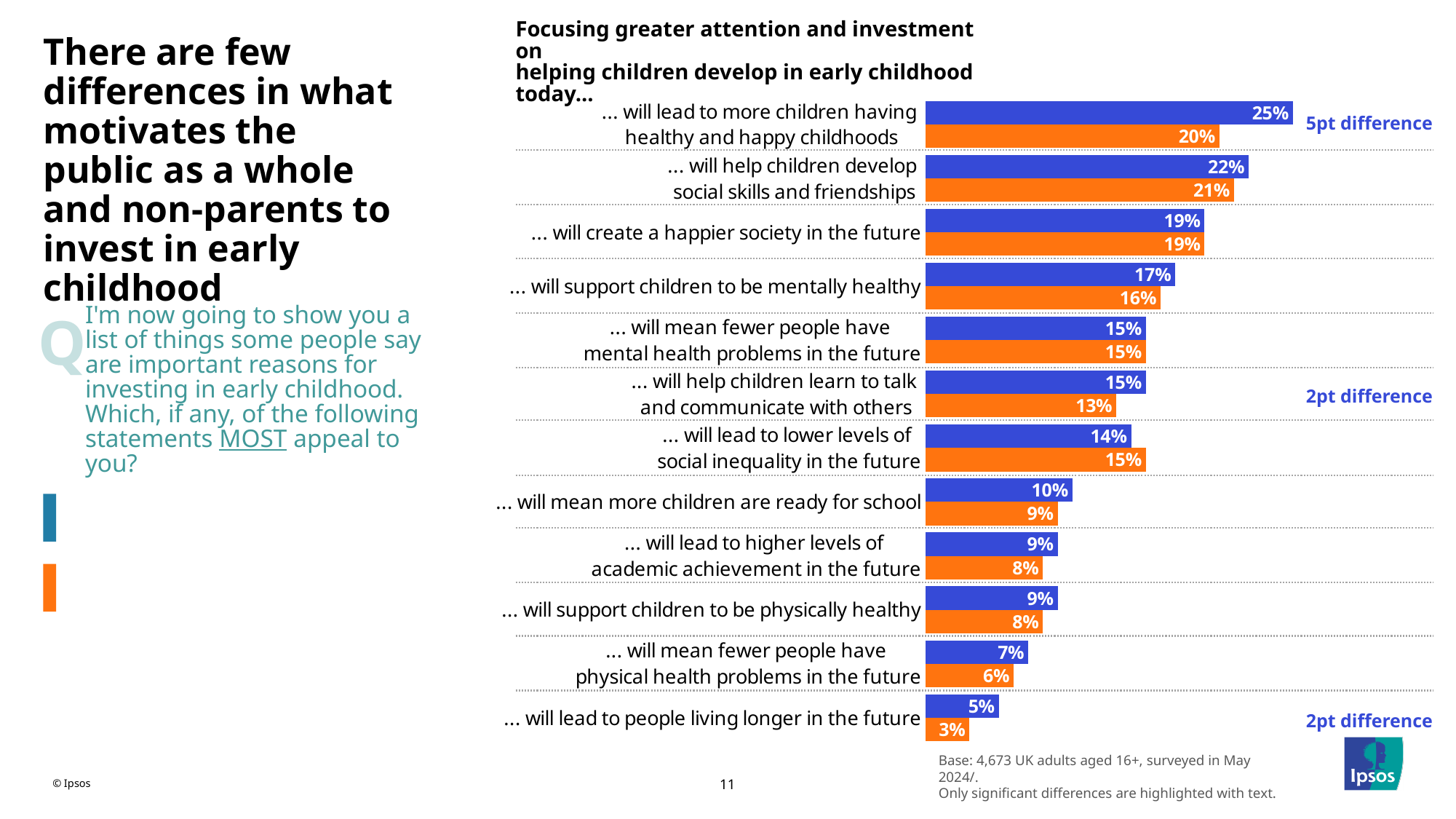
How many statements (categories) are listed in the chart? 12 For '... will lead to lower levels of social inequality in the future', which bar is larger, blue or orange? orange What annotation is shown next to the bars for '... will lead to people living longer in the future'? 2pt difference What is the value of the blue bar for '... will support children to be mentally healthy'? 17% What is the difference between the blue and orange bars for '... will lead to more children having healthy and happy childhoods'? 5% What is the value of the orange bar for '... will help children develop social skills and friendships'? 21% What kind of chart is shown on the slide? bar chart Which statement has the highest blue bar value? ... will lead to more children having healthy and happy childhoods What is the value of the orange bar for '... will lead to people living longer in the future'? 3% Which statement has the lowest orange bar value? ... will lead to people living longer in the future What is the difference between the blue and orange bars for '... will help children learn to talk and communicate with others'? 2% What is the value of the blue bar for '... will lead to more children having healthy and happy childhoods'? 25%